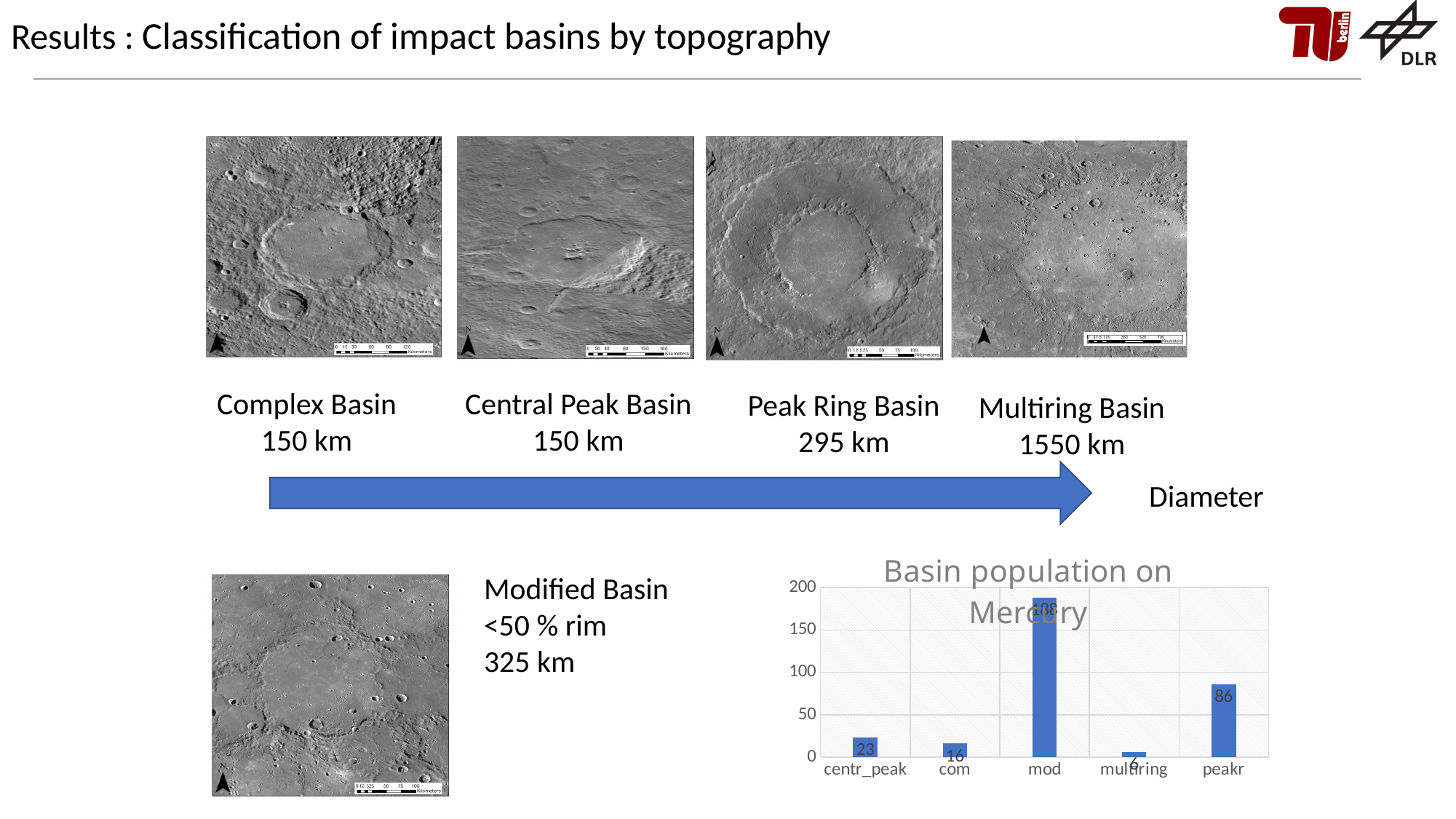
Which category has the lowest value in the chart? multiring What is the value for multiring in the chart? 6 What is the value for com in the chart? 16 What is the difference between the values for peakr and centr_peak? 63 How many categories are shown on the x axis of the chart? 5 What type of chart is shown on the slide? bar chart What is the title of the chart? Basin population on Mercury Which is larger, the value for centr_peak or the value for com? centr_peak What is the value for peakr in the chart? 86 Is the value for mod greater or less than 150? greater Which category has the highest value in the chart? mod What is the value for centr_peak in the chart? 23